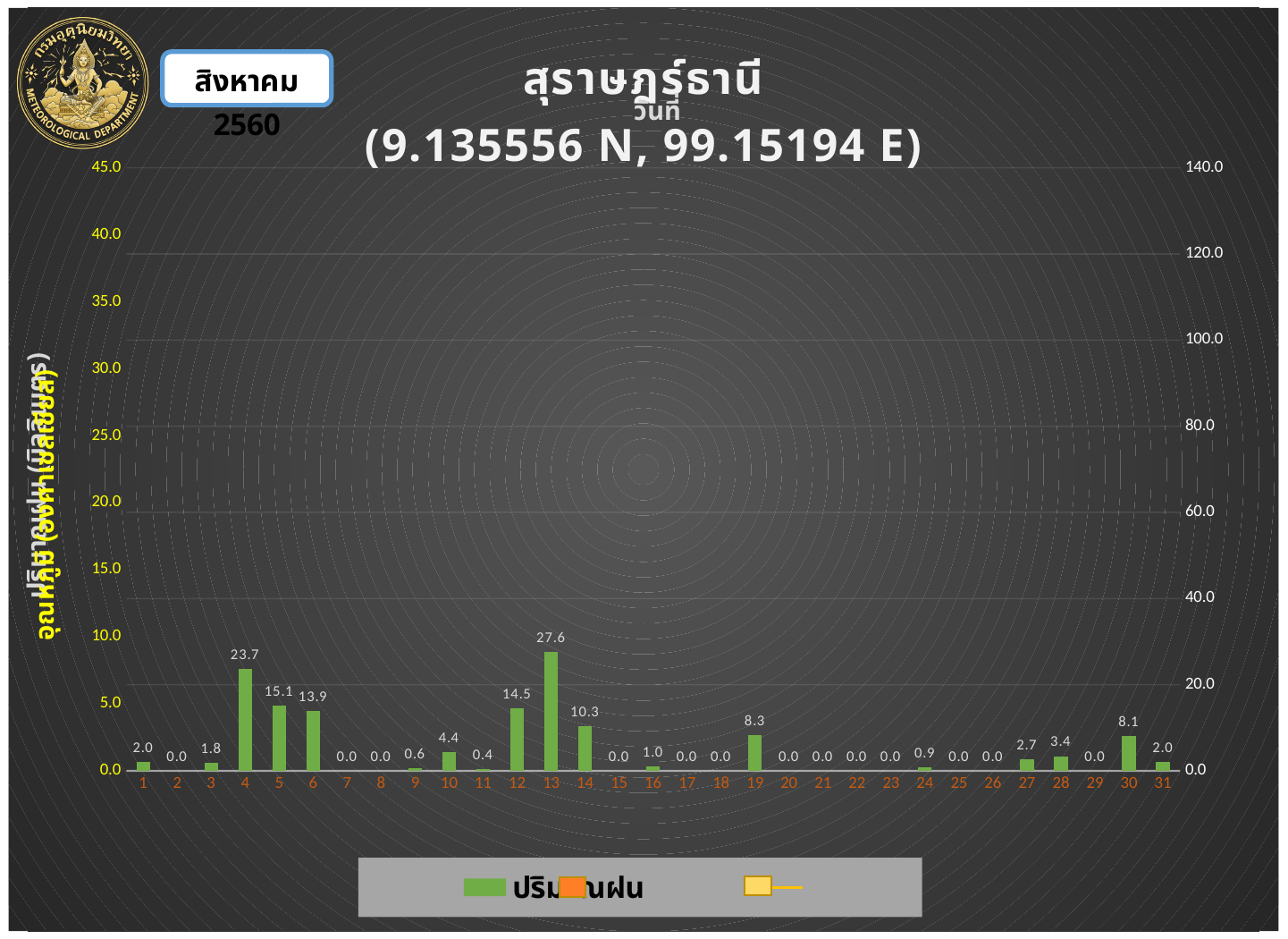
What are the coordinates shown in the chart title? 9.135556 N, 99.15194 E What is the rainfall value for day 28? 3.4 What is the rainfall value for day 4? 23.7 Which day has the highest rainfall value? 13 Which is larger, the rainfall value for day 12 or for day 14? day 12 What is the rainfall value for day 30? 8.1 What is the difference between the rainfall values for day 13 and day 4? 3.9 What kind of chart is shown on the slide? bar chart How many days are shown on the x axis? 31 What is the difference between the rainfall values for day 5 and day 6? 1.2 Which is larger, the rainfall value for day 19 or for day 30? day 19 What is the rainfall value for day 13? 27.6